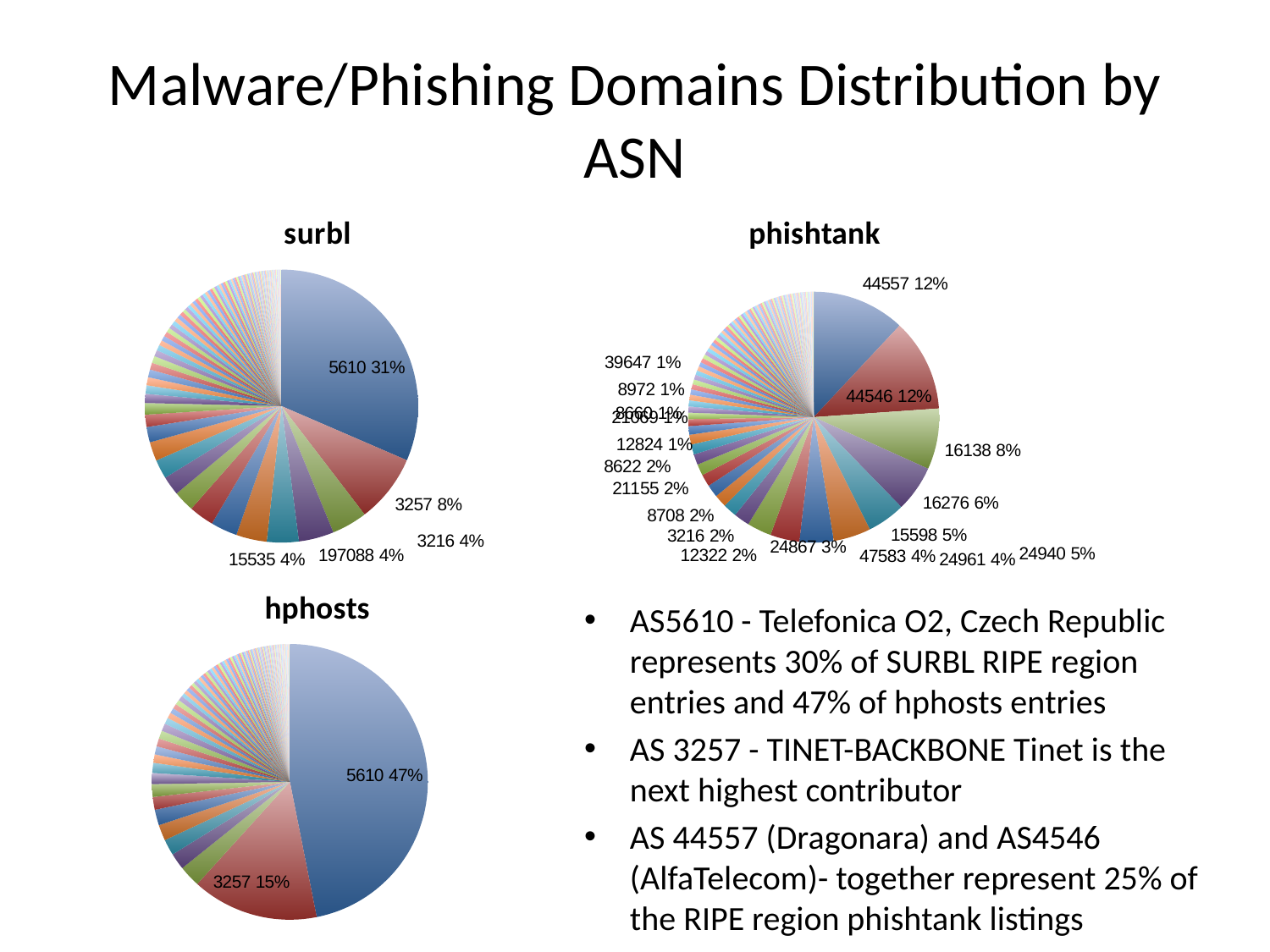
In the surbl pie chart, what is the difference in percentage points between the slices for 5610 and 3257? 23 In the hphosts pie chart, what percentage is labelled for ASN 3257? 15% In the phishtank pie chart, what percentage is labelled for ASN 16138? 8% In the phishtank pie chart, what percentage is labelled for ASN 44557? 12% In the surbl pie chart, what share of the pie does ASN 5610 represent? 31% In the hphosts pie chart, which ASN has the largest slice? 5610 In the surbl pie chart, which ASN has the largest slice? 5610 What kind of chart is the hphosts chart? Pie chart What is the title of the chart in the top right of the slide? phishtank In the hphosts pie chart, what share of the pie does ASN 5610 represent? 47% In the phishtank pie chart, which slice is larger, 16276 or 15598? 16276 In the surbl pie chart, what percentage is labelled for ASN 3257? 8%